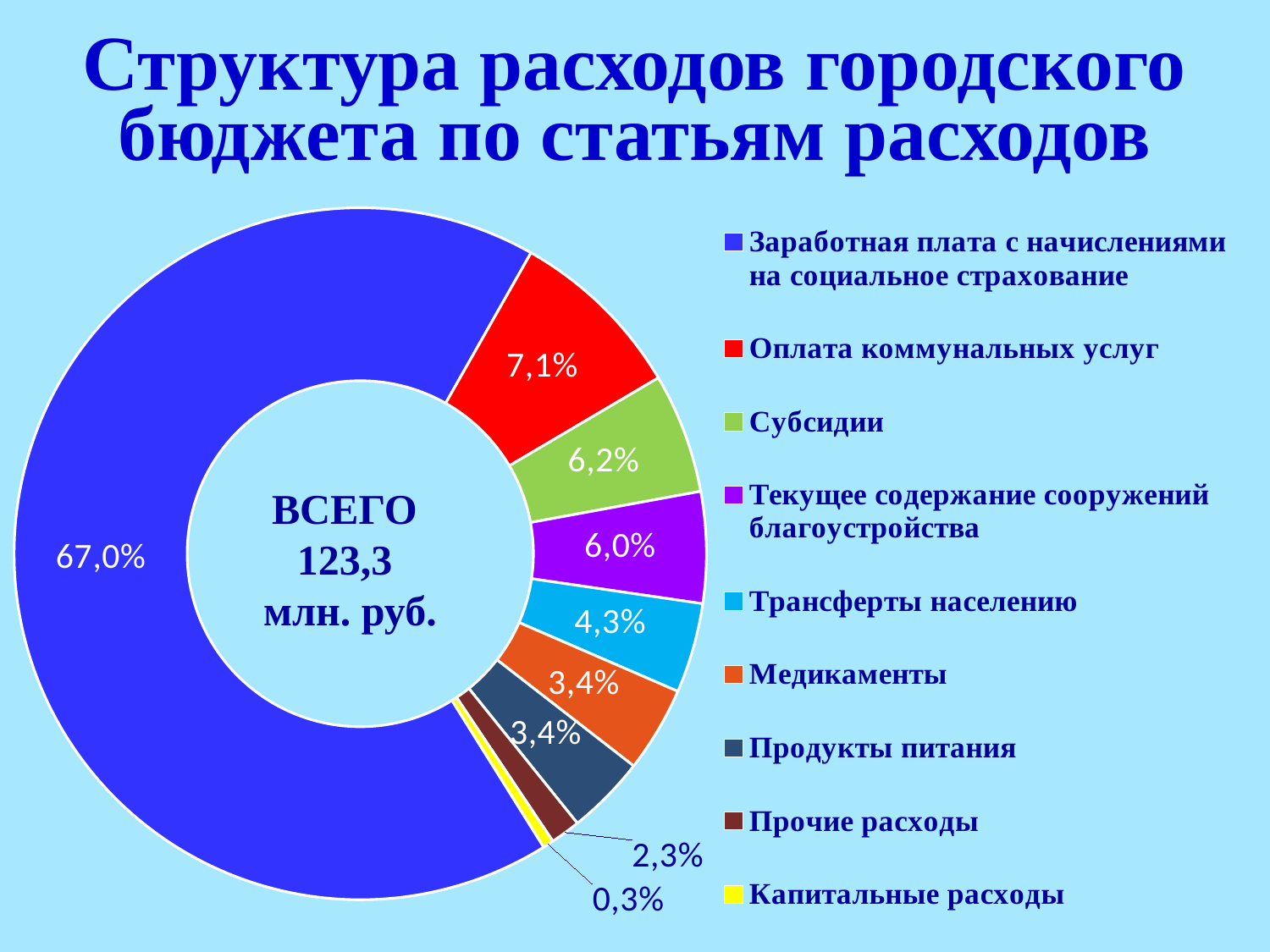
What percentage is shown for Субсидии? 6,2% What share of the city budget expenditure goes to Заработная плата с начислениями на социальное страхование? 67,0% Which expenditure item has the smallest share of the budget? Капитальные расходы What share is shown for Трансферты населению? 4,3% How many expenditure items does the legend list? 9 What share of expenditure is Оплата коммунальных услуг? 7,1% What is the difference in percentage points between Оплата коммунальных услуг and Субсидии? 0,9 What type of chart is shown on the slide? Doughnut chart What percentage is shown for Капитальные расходы? 0,3% Which expenditure item has the largest share of the budget? Заработная плата с начислениями на социальное страхование Which has a larger share: Текущее содержание сооружений благоустройства or Трансферты населению? Текущее содержание сооружений благоустройства What total amount is shown in the centre of the chart? 123,3 млн. руб.